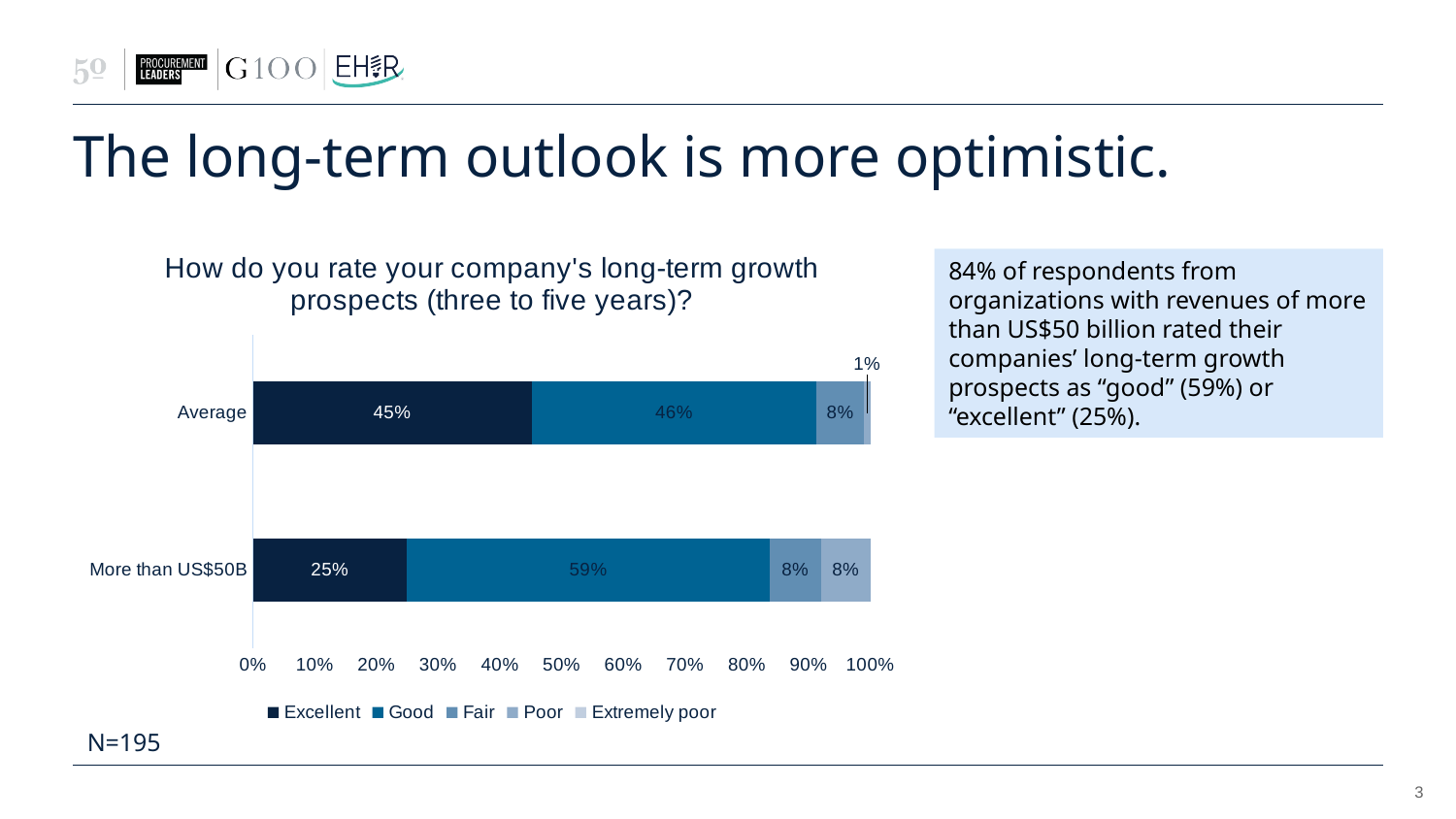
What is the Poor share for the More than US$50B category? 8% How many categories (bars) are shown in the chart? 2 How many series does the legend list? 5 How much larger is the Excellent share for Average than for More than US$50B? 20 percentage points What is the title of the chart? How do you rate your company's long-term growth prospects (three to five years)? Which category has the larger Good share, Average or More than US$50B? More than US$50B What percentage of respondents from organizations with more than US$50B in revenue rated their prospects as Good? 59% What is the combined share of Excellent and Good ratings for the More than US$50B category? 84% Which rating has the largest share in the Average category? Good What is the Fair share for the Average category? 8% What type of chart is shown on the slide? Stacked bar chart What percentage of respondents in the Average category rated their long-term growth prospects as Excellent? 45%